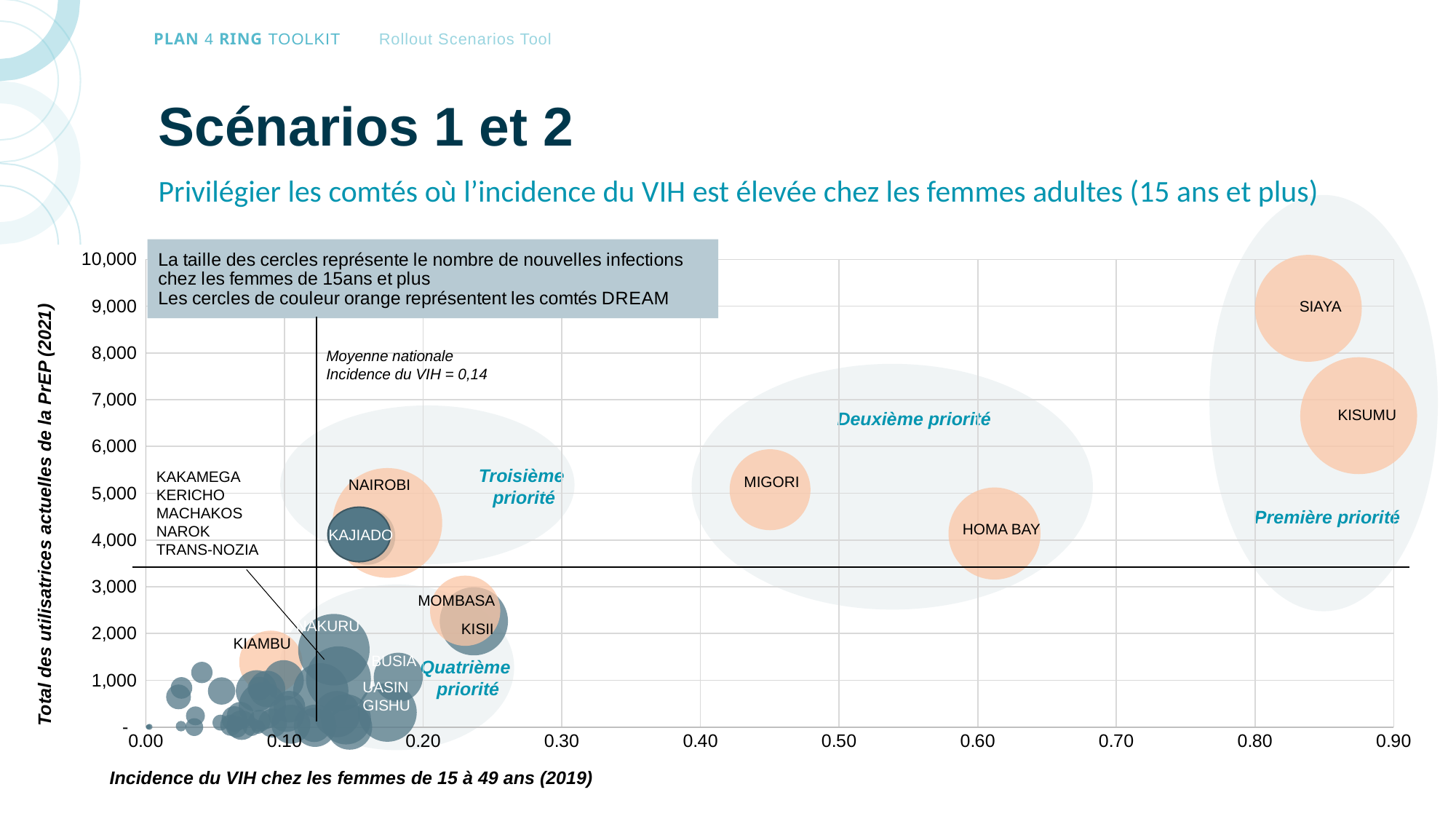
Is the total of current PrEP users for HOMA BAY greater or less than 5,000? less Which county has the highest total of current PrEP users (2021)? SIAYA What kind of chart is shown on the slide? bubble chart Is the HIV incidence value for NAIROBI greater or less than 0.20? less Is the HIV incidence value for MIGORI greater or less than 0.40? greater Which county has more current PrEP users, SIAYA or KISUMU? SIAYA What national average HIV incidence is marked by the vertical reference line on the chart? 0,14 Which county has the highest HIV incidence among women aged 15 to 49 (2019)? KISUMU Which county has a higher HIV incidence, MIGORI or HOMA BAY? HOMA BAY